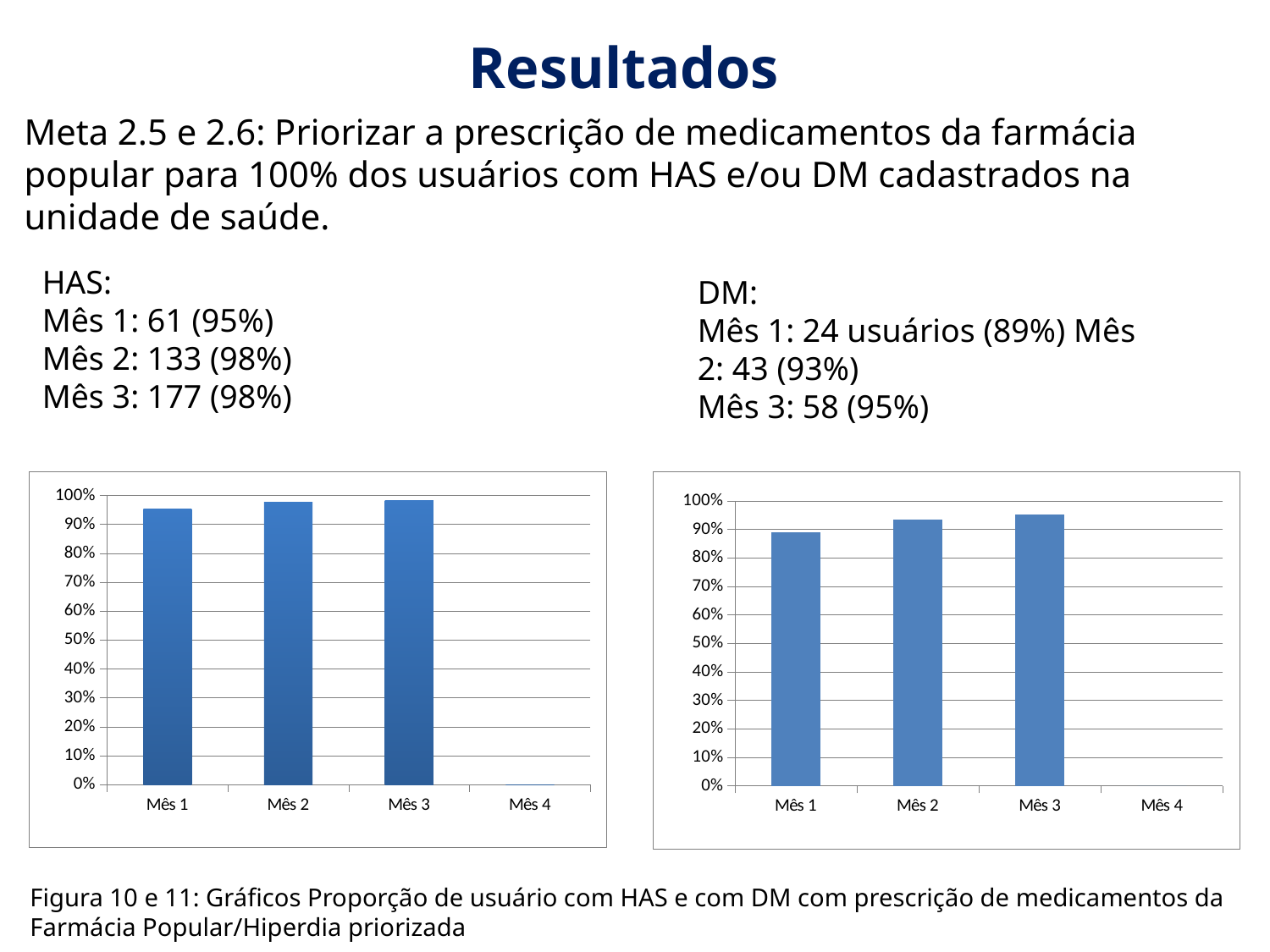
In the left chart (HAS), which month has the lowest bar? Mês 1 In the left chart (HAS), is the value for Mês 1 greater or less than 90%? greater In the right chart (DM), which month has the lowest bar? Mês 1 In the left chart (HAS), how many categories are labelled on the x axis? 4 What kind of chart is the left chart (HAS)? bar chart In the right chart (DM), is the value for Mês 1 greater or less than 90%? less In the right chart (DM), is the bar for Mês 2 taller or shorter than the bar for Mês 1? taller In the right chart (DM), what is the value for Mês 3, as printed in the slide text? 95% Which x-axis category has no bar in either chart? Mês 4 In the right chart (DM), which month has the highest bar? Mês 3 In the left chart (HAS), what is the value for Mês 1, as printed in the slide text? 95% In the left chart (HAS), do the bars rise or fall from Mês 1 to Mês 3? rise